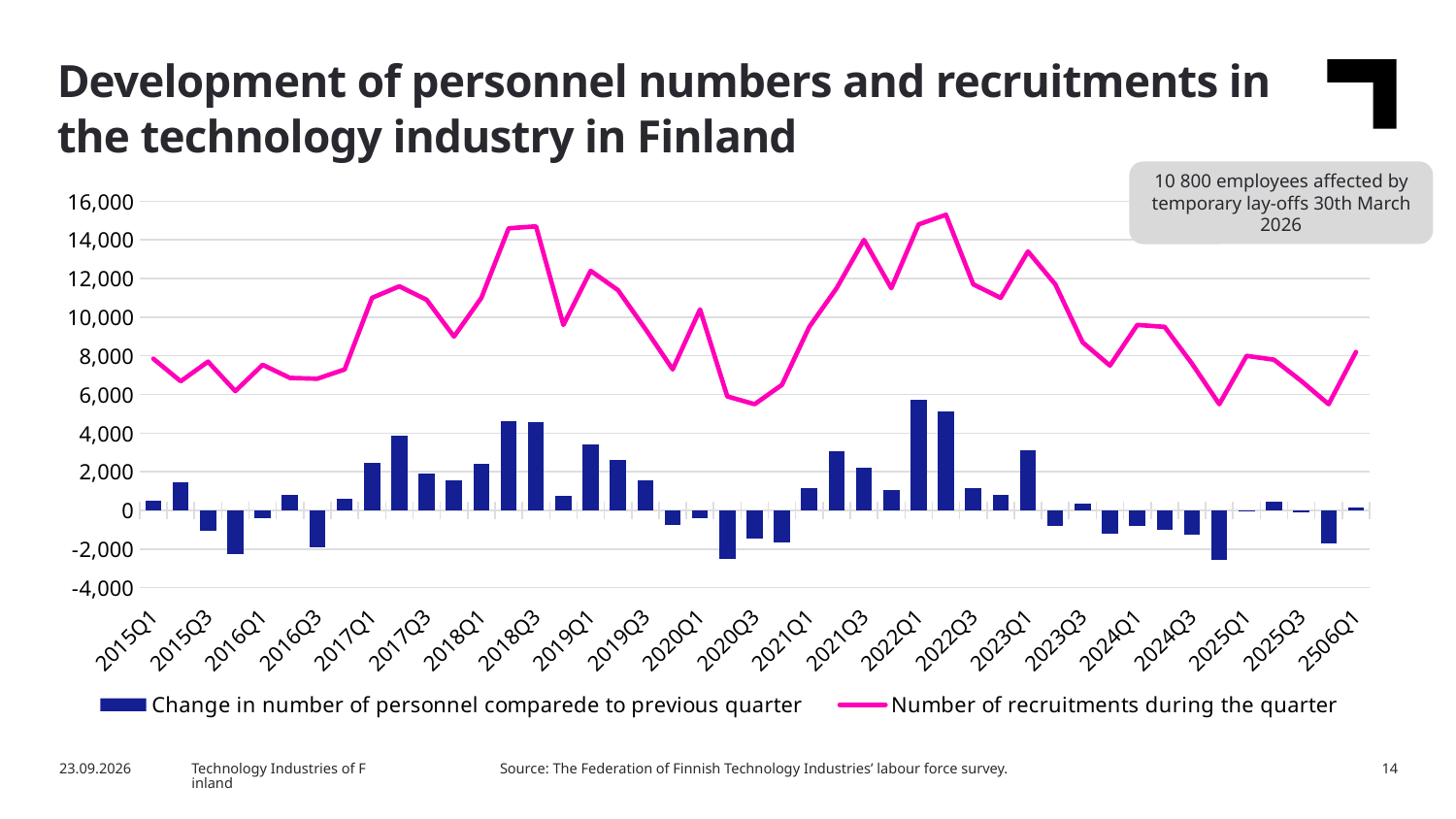
Is the number of recruitments in 2018Q3 greater or less than 14,000? greater How many series does the legend list? 2 Is the number of recruitments in 2024Q1 greater or less than 8,000? greater Which series is drawn as a line? Number of recruitments during the quarter Is the change in number of personnel in 2020Q2 greater or less than -2,000? less Does the number of recruitments generally rise or fall from 2022Q1 to 2025Q3? fall Which is larger, the number of recruitments in 2018Q3 or in 2020Q3? 2018Q3 Which is larger, the change in number of personnel in 2022Q1 or in 2023Q3? 2022Q1 What is the title of the chart? Development of personnel numbers and recruitments in the technology industry in Finland What kind of chart is shown on the slide? A combined bar and line chart